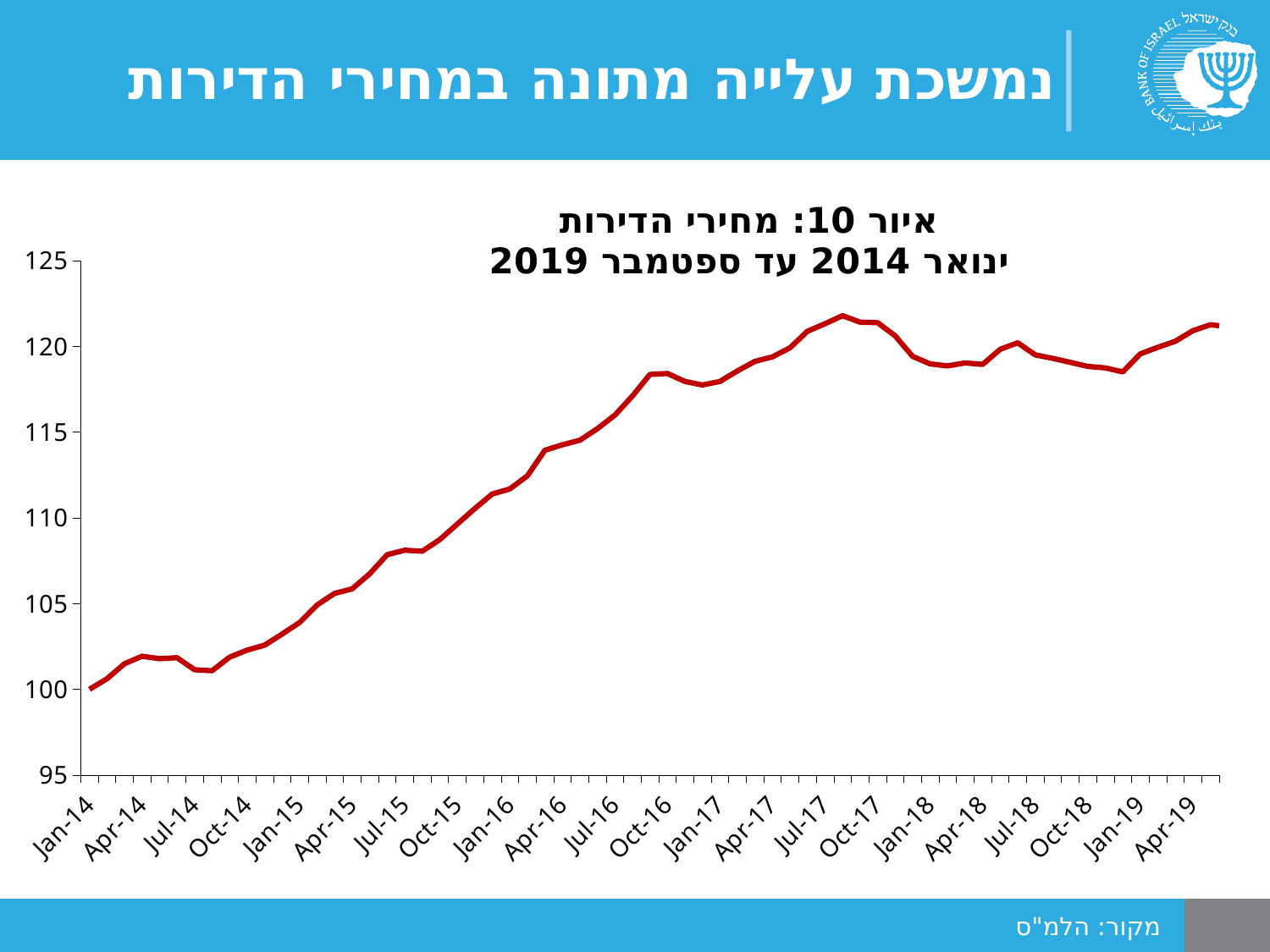
Which is larger, the value for Jan-15 or the value for Jan-16? Jan-16 What kind of chart is shown on the slide? line chart What is the title of the chart? איור 10: מחירי הדירות ינואר 2014 עד ספטמבר 2019 Is the value for Oct-14 greater or less than 105? less Is the value for Jan-16 greater or less than 110? greater Overall, do the values rise or fall from Jan-14 to the end of the series? rise What colour is the line in the chart? red What is the value of the index at Jan-14? 100 Is the value for Jul-17 greater or less than 120? greater Which is larger, the value for Jul-17 or the value for Jan-19? Jul-17 Which point on the x axis has the lowest value? Jan-14